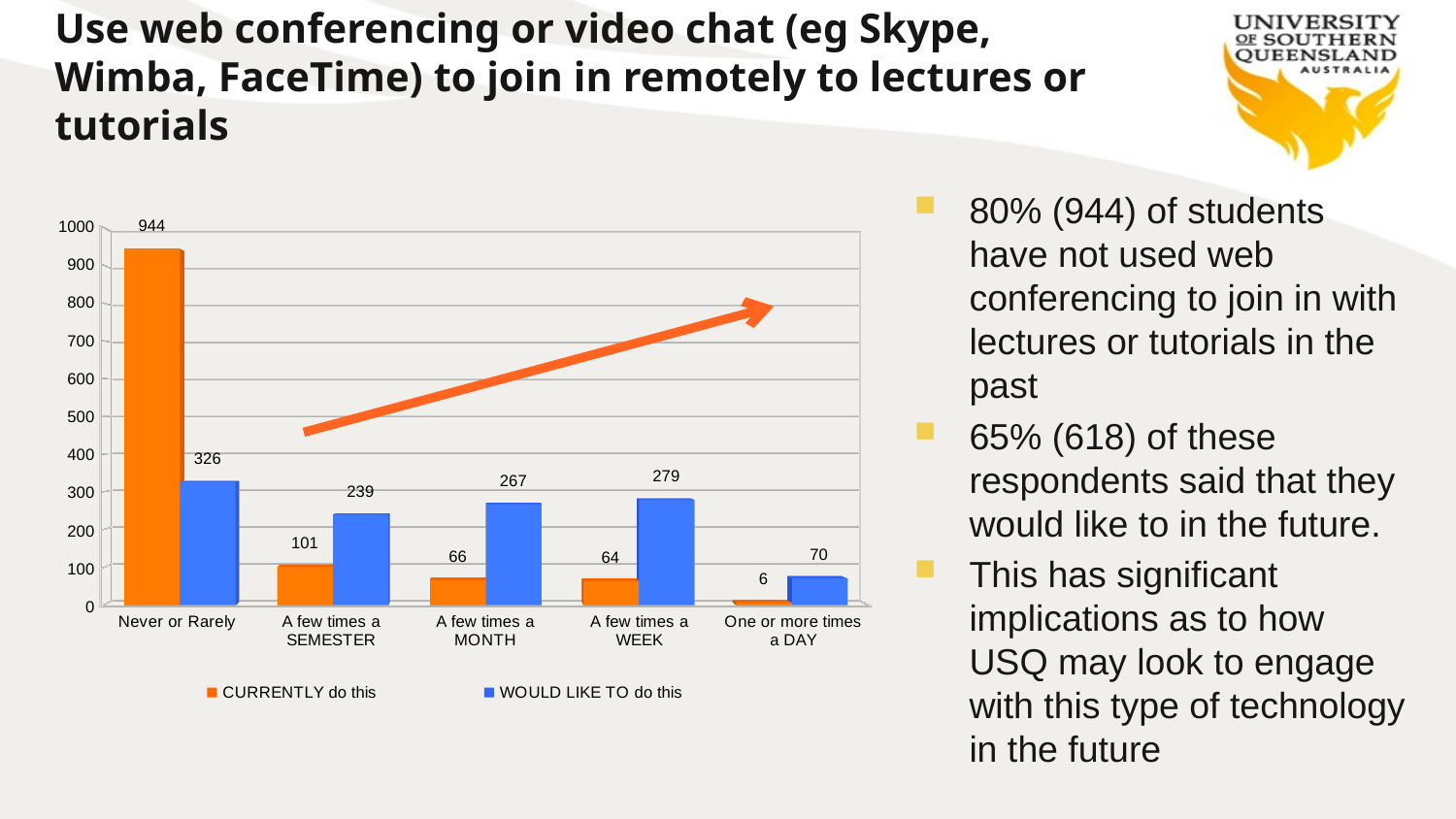
Which category has the lowest value for 'WOULD LIKE TO do this'? One or more times a DAY What is the value for 'WOULD LIKE TO do this' in the 'A few times a WEEK' category? 279 How many series does the legend list? 2 What is the value for 'CURRENTLY do this' in the 'Never or Rarely' category? 944 What is the value for 'CURRENTLY do this' in the 'One or more times a DAY' category? 6 How many categories are shown on the x axis? 5 In the 'A few times a MONTH' category, which series has the larger value? WOULD LIKE TO do this What is the difference between 'CURRENTLY do this' and 'WOULD LIKE TO do this' in the 'Never or Rarely' category? 618 Which category has the highest value for 'CURRENTLY do this'? Never or Rarely Is the value for 'WOULD LIKE TO do this' in 'A few times a SEMESTER' greater or less than 200? greater What kind of chart is shown on the slide? Bar chart Do the values for 'CURRENTLY do this' rise or fall from left to right along the x axis? Fall